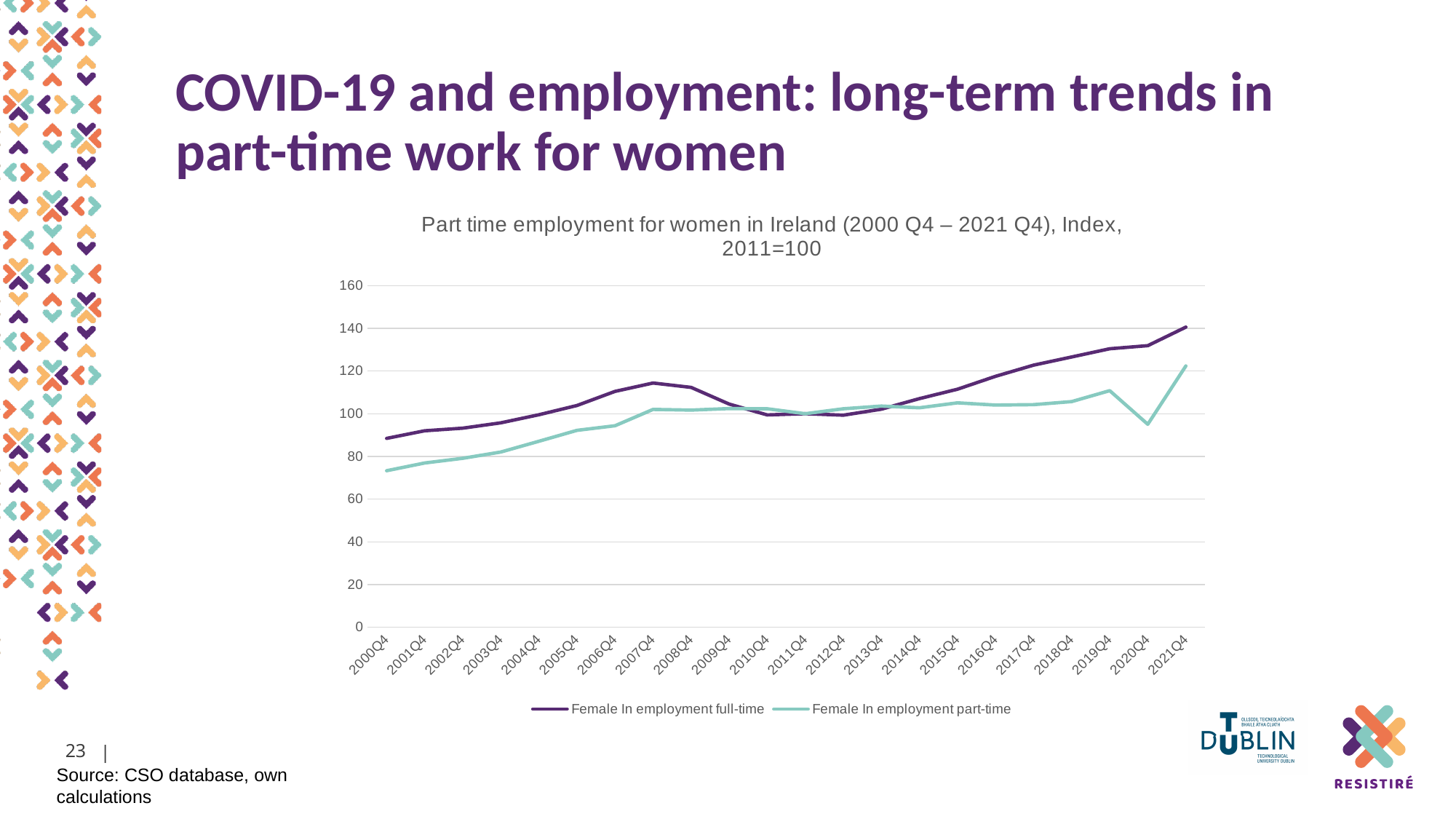
Is the value for Female In employment part-time in 2000Q4 greater or less than 80? less In 2021Q4, which series has the higher value, full-time or part-time? Female In employment full-time What is the index value of both series in 2011Q4, the base year? 100 How many quarters are plotted along the x axis? 22 Is the value for Female In employment full-time in 2021Q4 greater or less than 120? greater Does the Female In employment full-time series rise or fall between 2007Q4 and 2010Q4? fall What is the title of the chart? Part time employment for women in Ireland (2000 Q4 – 2021 Q4), Index, 2011=100 What kind of chart is shown on the slide? line chart What are the two series named in the legend? Female In employment full-time; Female In employment part-time In which quarter does the Female In employment full-time series reach its highest value? 2021Q4 Is the value for Female In employment part-time in 2020Q4 greater or less than 100? less How many series does the legend list? 2